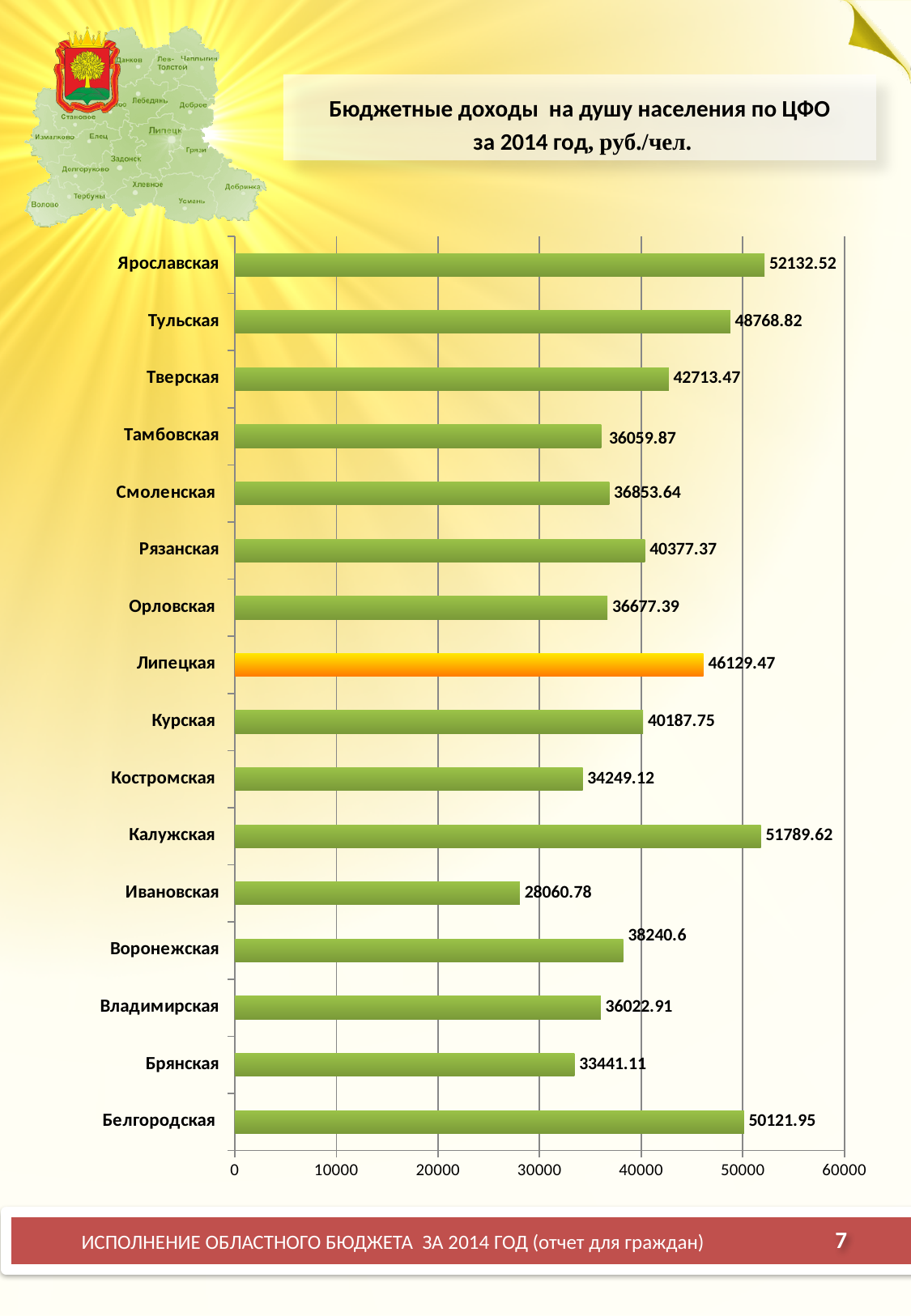
What is the difference between the values for Ярославская and Калужская? 342.9 Which region has the highest value? Ярославская What kind of chart is shown on the slide? bar chart What is the value for Белгородская? 50121.95 Which is larger, the value for Тульская or the value for Белгородская? Белгородская How many regions are shown in the chart? 16 What is the value for Липецкая? 46129.47 Is the value for Ивановская greater or less than 30000? less Which bar is highlighted in a different colour (orange) from the others? Липецкая Which region has the lowest value? Ивановская What is the difference between the values for Липецкая and Курская? 5941.72 What is the value for Воронежская? 38240.6